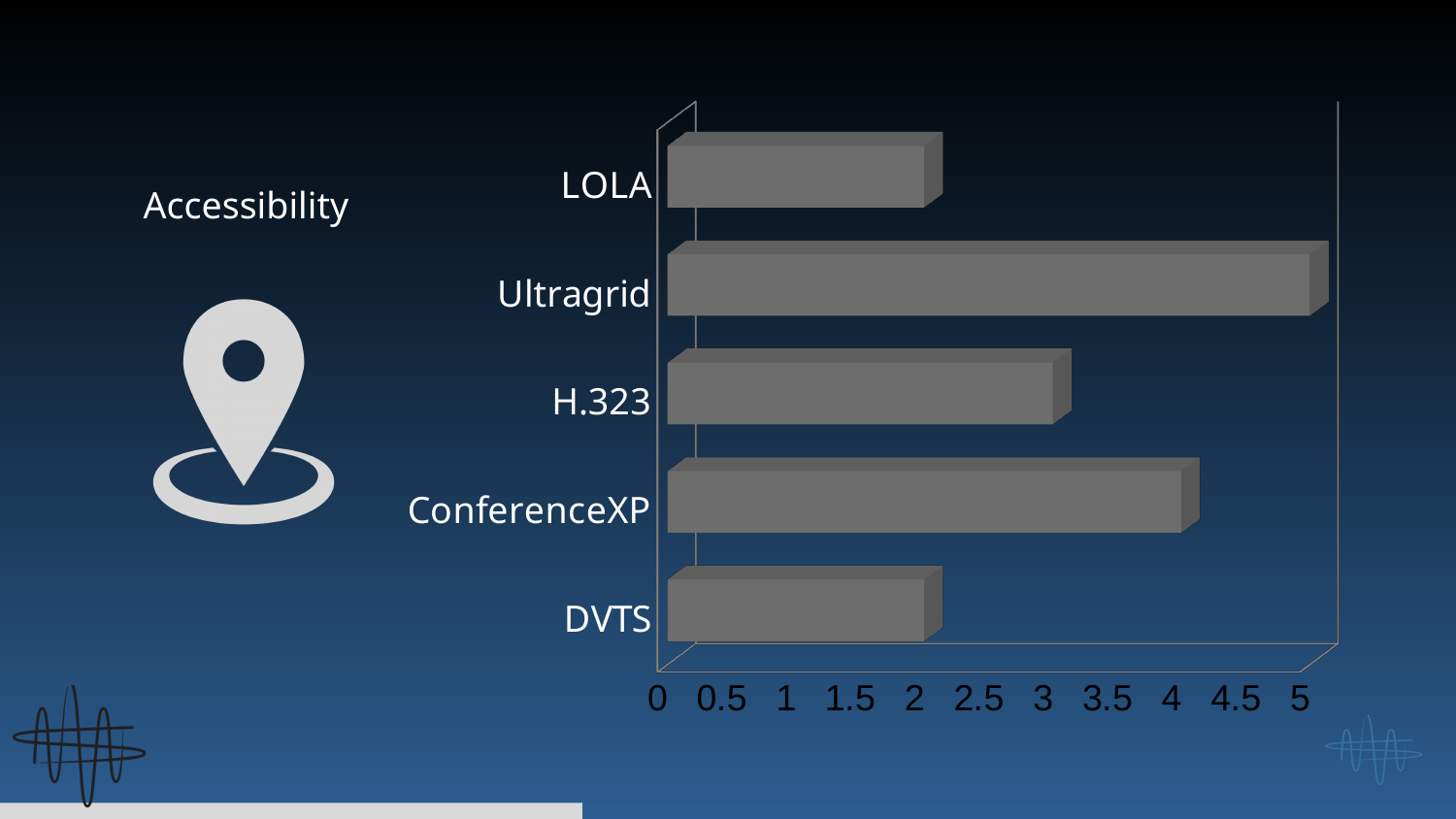
Is the value for LOLA greater or less than 3? less Which has the larger value, H.323 or DVTS? H.323 Which category has the highest value in the chart? Ultragrid Is the value for DVTS greater or less than 3? less Which has the larger value, ConferenceXP or LOLA? ConferenceXP What kind of chart is shown on the slide? bar chart Is the value for H.323 greater or less than 4? less Which has the larger value, Ultragrid or H.323? Ultragrid How many categories are plotted in the chart? 5 What is the highest value shown on the chart's horizontal axis? 5